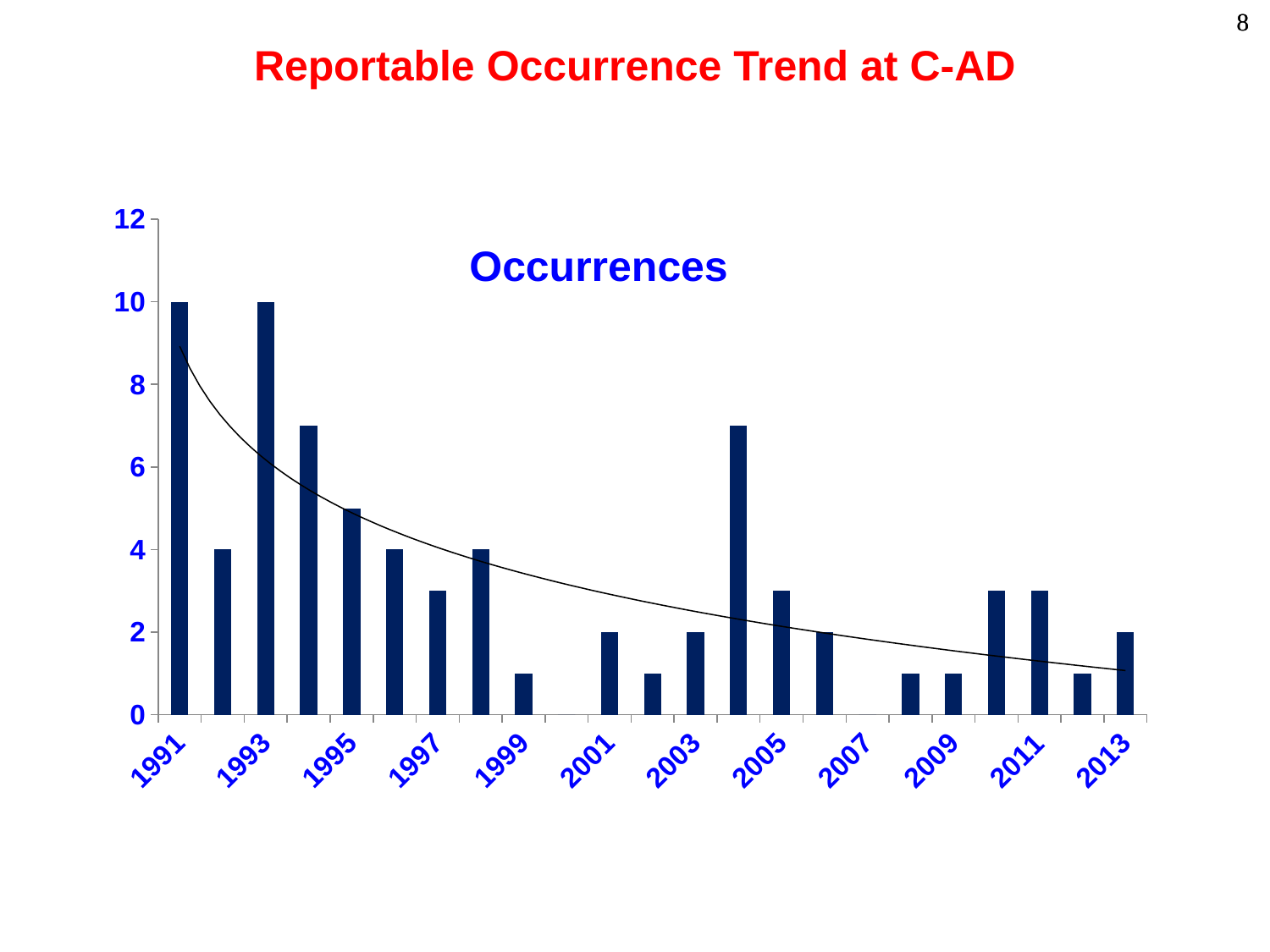
Overall, do the occurrences rise or fall from 1991 to 2013? fall What is the number of occurrences for 2013? 2 What type of chart is shown on the slide? bar chart What is the title printed inside the chart area? Occurrences What is the number of occurrences for 1991? 10 Is the value for 1999 greater or less than 2? less What is the number of occurrences for 1993? 10 What is the difference in occurrences between 1993 and 2013? 8 Which year has more occurrences, 1991 or 1995? 1991 What is the number of occurrences for 2001? 2 Which years have the highest number of occurrences? 1991 and 1993 Is the value for 1995 greater or less than 4? greater